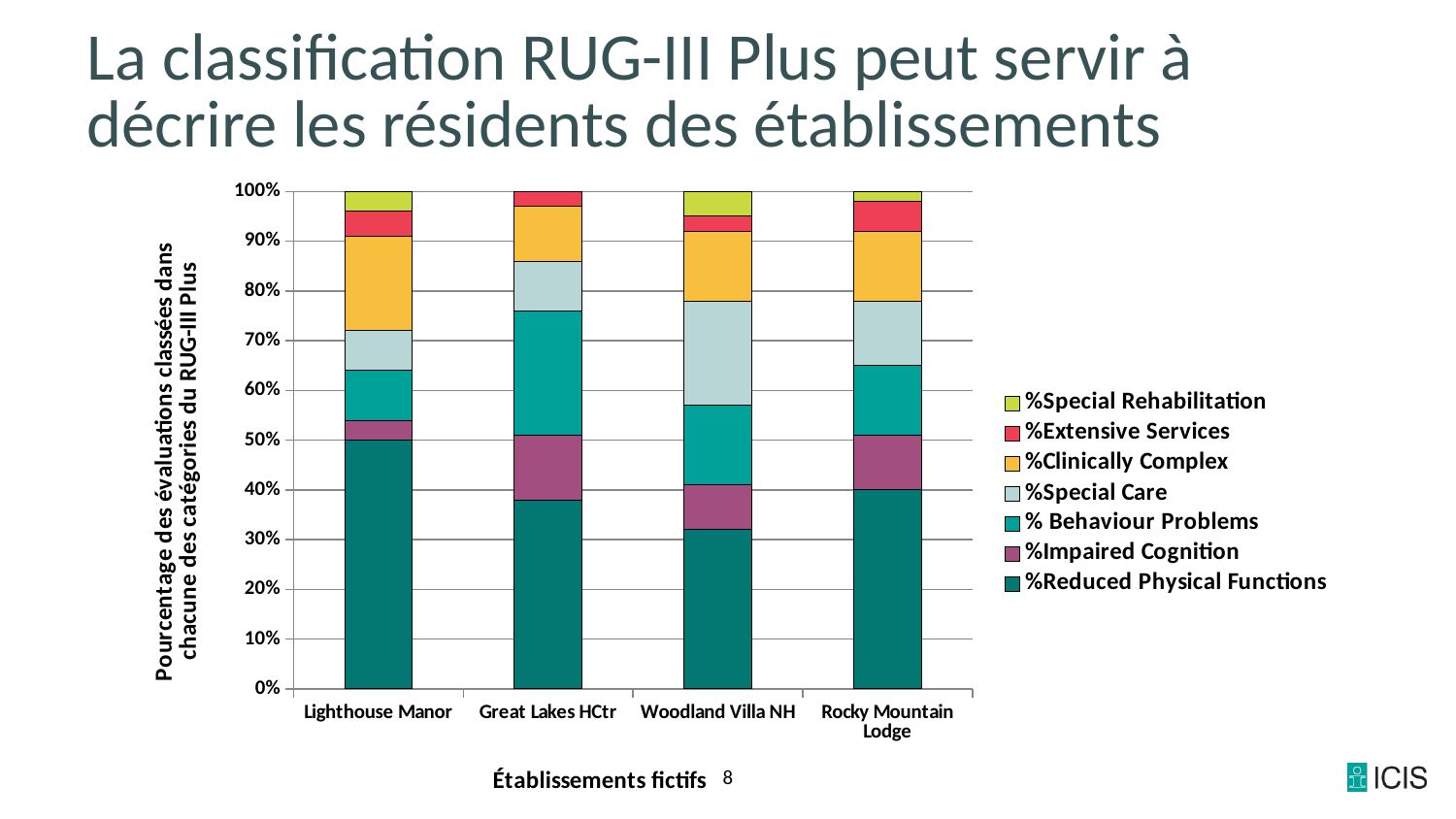
What is the title of the x axis of the chart? Établissements fictifs How many series does the chart's legend list? 7 Is the %Special Care segment larger for Woodland Villa NH or for Great Lakes HCtr? Woodland Villa NH Is the %Reduced Physical Functions value for Rocky Mountain Lodge greater or less than 30%? greater Is the %Reduced Physical Functions value for Woodland Villa NH greater or less than 40%? less What is the total height of the Lighthouse Manor stacked bar? 100% How many establishments are shown along the x axis of the chart? 4 Which establishment has the largest %Reduced Physical Functions segment? Lighthouse Manor What kind of chart is shown on the slide? Stacked bar chart Is the % Behaviour Problems segment larger for Great Lakes HCtr or for Lighthouse Manor? Great Lakes HCtr Which establishment has the smallest %Reduced Physical Functions segment? Woodland Villa NH Is the %Reduced Physical Functions value for Lighthouse Manor greater or less than 40%? greater